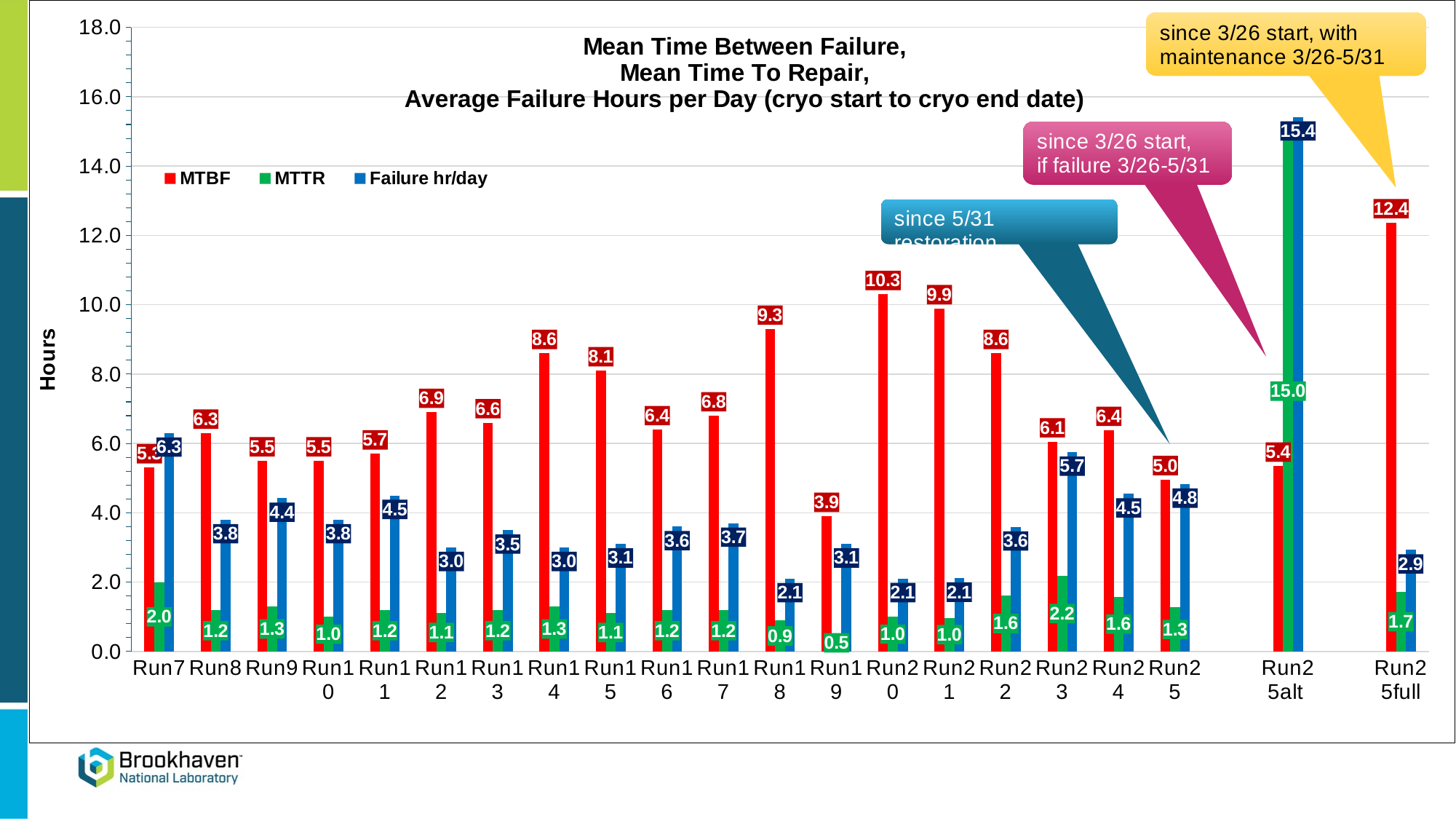
Which run has the lowest MTBF value? Run19 How many run categories are shown on the x axis? 21 What is the MTTR value for Run25alt? 15.0 What is the MTBF value for Run20? 10.3 How many series does the legend list? 3 Which run has the highest MTBF value? Run25full What is the Failure hr/day value for Run23? 5.7 Which run has the highest Failure hr/day value? Run25alt What kind of chart is shown on the slide? Bar chart Which run has the lowest MTTR value? Run19 What is the difference between the MTBF values for Run25full and Run25? 7.4 Which is larger, the MTBF for Run18 or the MTBF for Run22? Run18